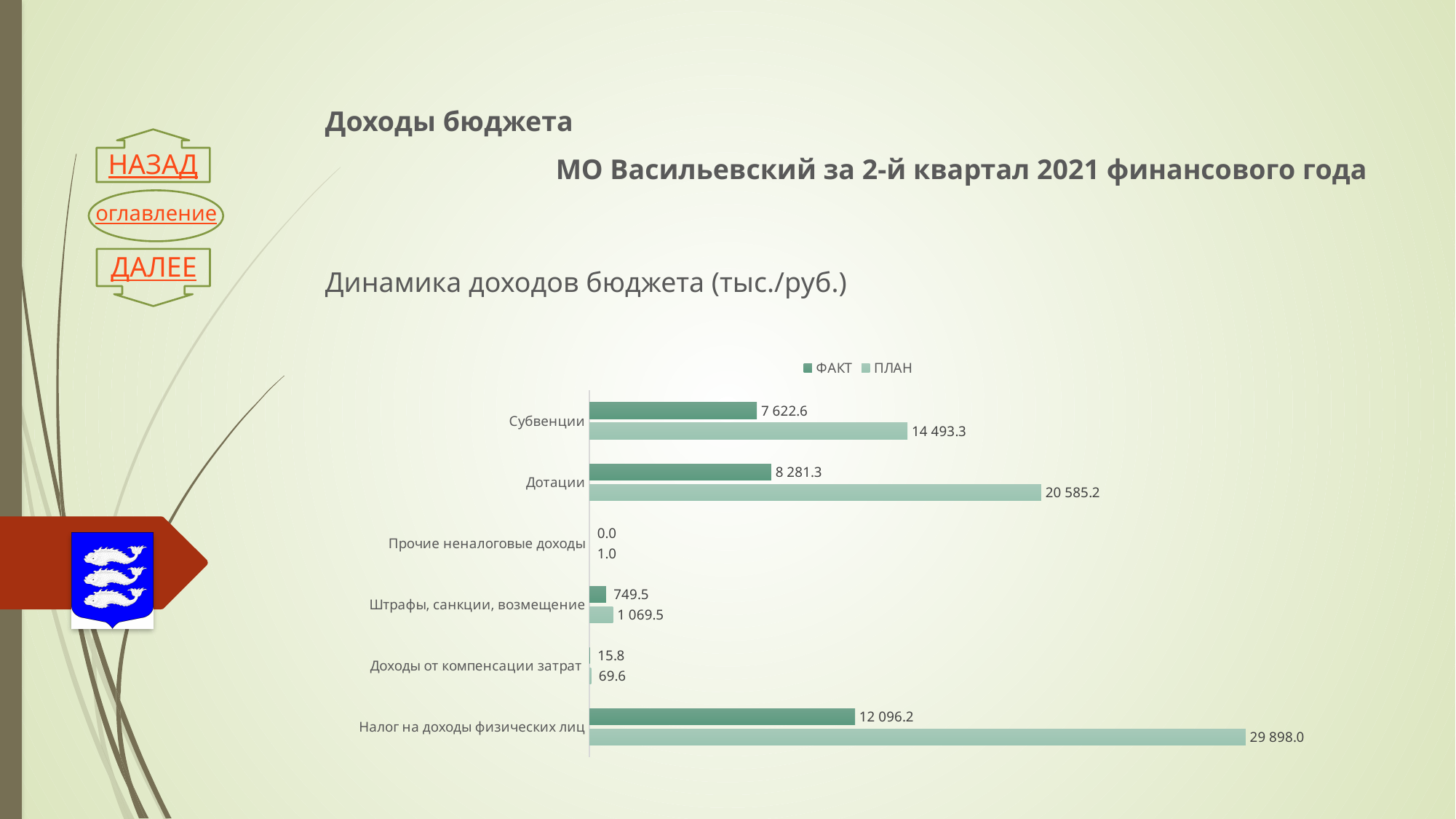
What is the ПЛАН value for Налог на доходы физических лиц? 29 898.0 How many categories are shown in the chart? 6 What is the ПЛАН value for Штрафы, санкции, возмещение? 1 069.5 What is the ФАКТ value for Доходы от компенсации затрат? 15.8 Which is larger: the ФАКТ value for Субвенции or the ФАКТ value for Дотации? Дотации Which category has the highest ПЛАН value? Налог на доходы физических лиц What is the ФАКТ value for Дотации? 8 281.3 Which category has the lowest ФАКТ value? Прочие неналоговые доходы What kind of chart is shown on the slide? Bar chart How many series does the legend list? 2 What is the difference between the ПЛАН and ФАКТ values for Дотации? 12 303.9 What is the difference between the ПЛАН and ФАКТ values for Налог на доходы физических лиц? 17 801.8